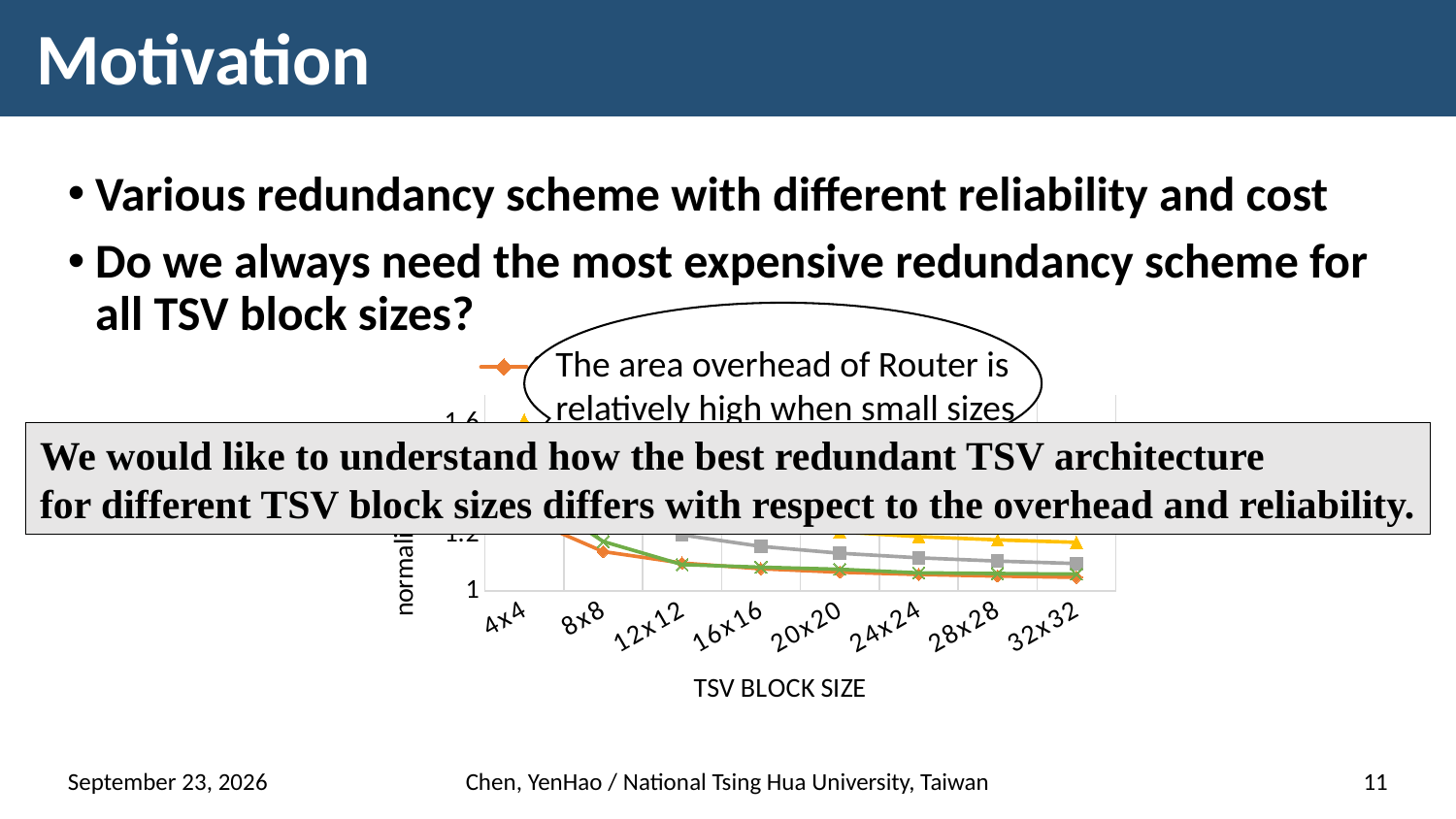
At 32x32, which is larger: the gray series or the orange series? gray series Which series has the highest value at 32x32? yellow series Is the value of the gray series at 32x32 greater or less than 1.2? less What kind of chart is shown on the slide? line chart What is the title of the x axis of the chart? TSV BLOCK SIZE At 32x32, which is larger: the yellow series or the green series? yellow series Do the plotted values rise or fall as the TSV block size increases along the x axis? fall Is the value of the orange series at 32x32 greater or less than 1.2? less What is the first TSV block size category on the x axis? 4x4 Is the value of the green series at 20x20 greater or less than 1.2? less How many TSV block sizes are shown on the x axis of the chart? 8